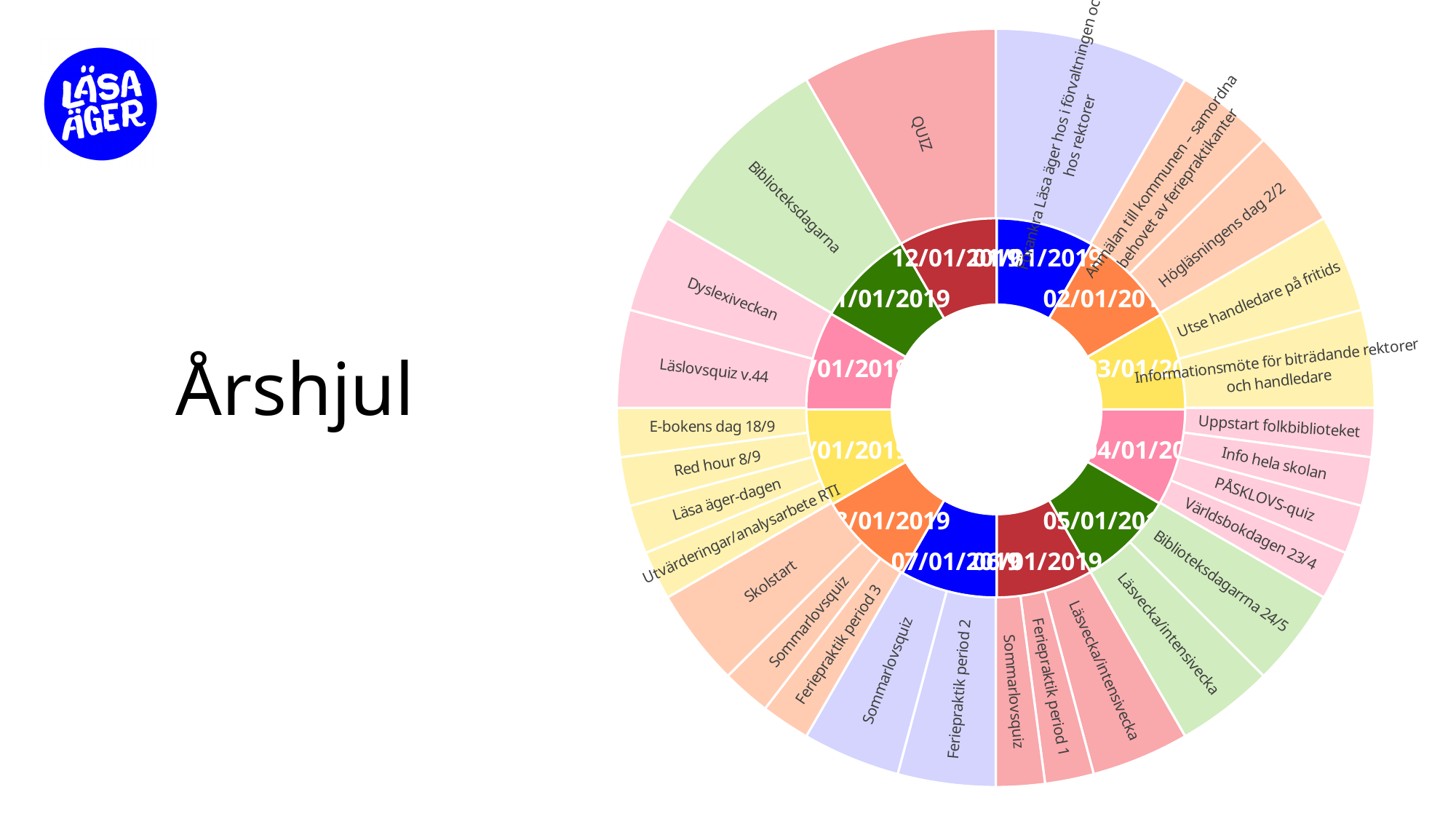
Which inner-ring segment does the outer-ring activity 'Feriepraktik period 2' belong to? 07/01/2019 Which outer-ring activity is attached to the 11/01/2019 segment? Biblioteksdagarna Which inner-ring segment does the outer-ring activity 'Dyslexiveckan' belong to? 10/01/2019 Which outer-ring activity is attached to the 12/01/2019 segment? QUIZ What is the title of the slide containing the chart? Årshjul Which inner-ring segment does the outer-ring activity 'Världsbokdagen 23/4' belong to? 04/01/2019 How many outer-ring activities are attached to the 08/01/2019 segment? 3 How many outer-ring activities are attached to the 09/01/2019 segment? 4 Which inner-ring segment does the outer-ring activity 'Högläsningens dag 2/2' belong to? 02/01/2019 How many outer-ring activities are attached to the 04/01/2019 segment? 4 What kind of chart is shown on the slide? Doughnut chart (two concentric doughnut rings)